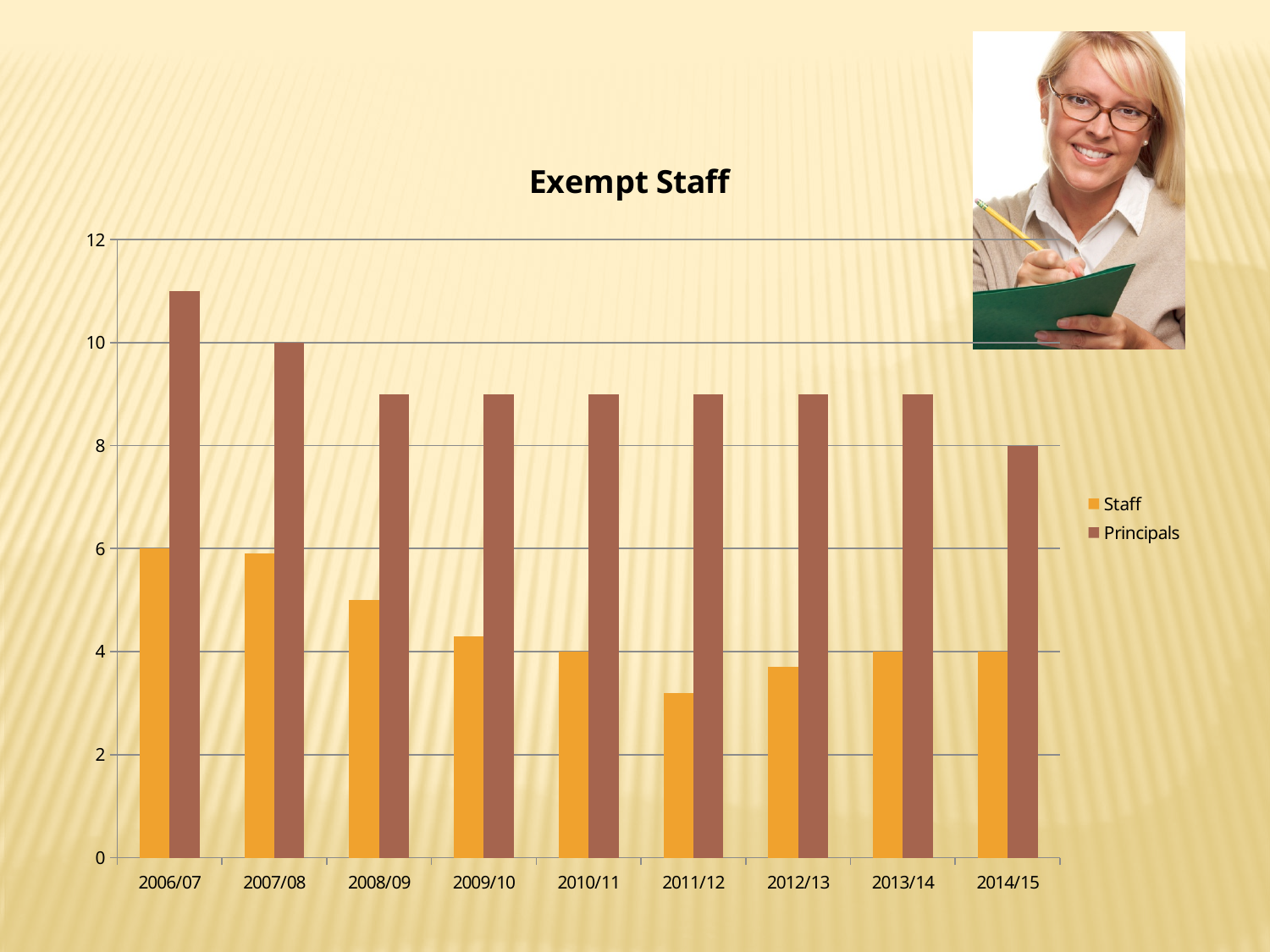
In which year is the Principals value highest? 2006/07 What is the value for Principals in 2014/15? 8 What is the value for Staff in 2006/07? 6 In which year is the Principals value lowest? 2014/15 What kind of chart is shown on the slide? bar chart Do the Principals values generally rise or fall from 2006/07 to 2014/15? fall Is the value for Staff in 2011/12 greater or less than 4? less Is the value for Principals in 2006/07 greater or less than 10? greater What is the value for Principals in 2007/08? 10 What is the title of the chart? Exempt Staff How many school years are shown on the x axis? 9 How many series does the legend list? 2